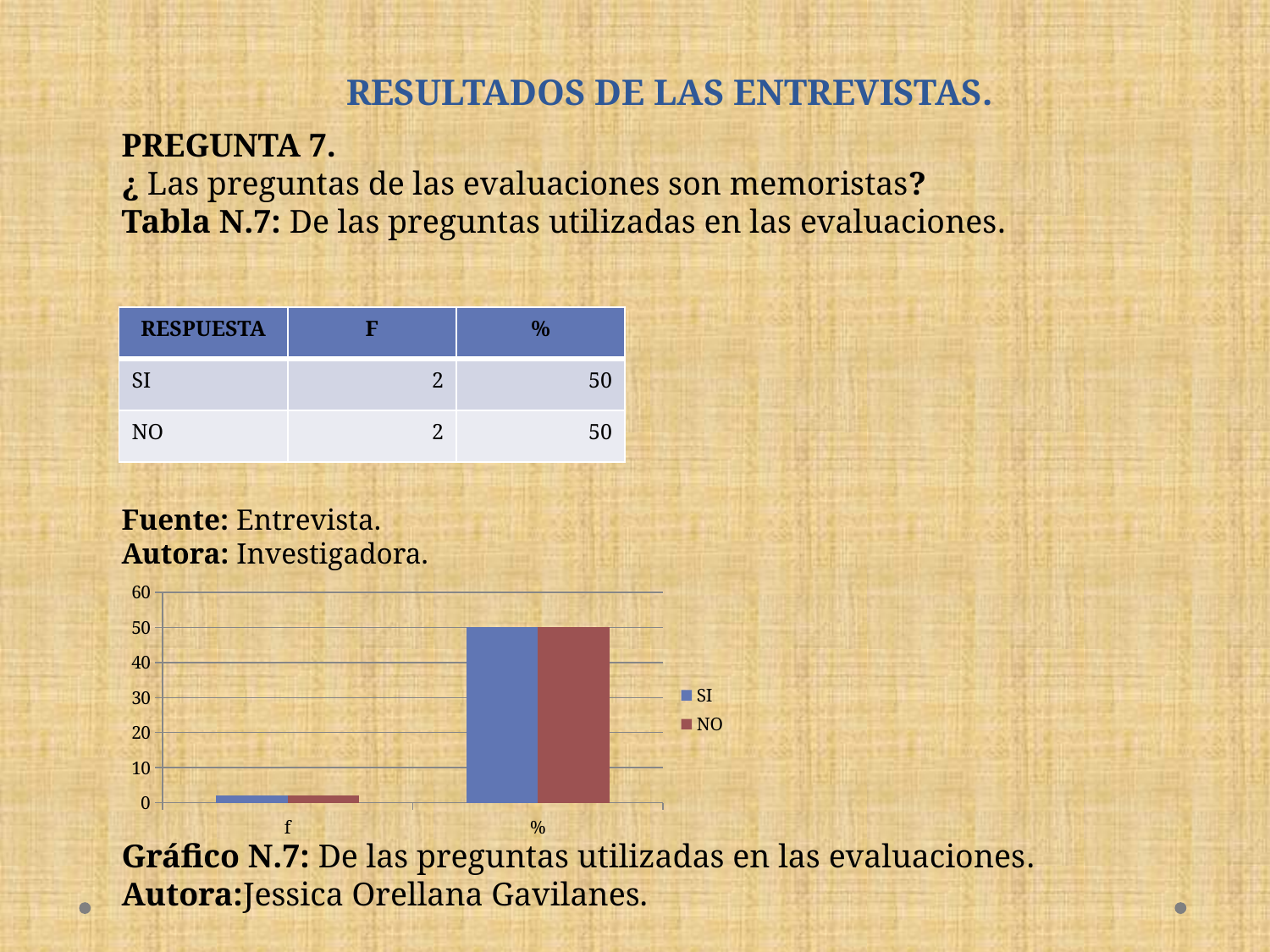
What are the category labels on the x axis of the chart? f and % What is the value of the SI bar for the % category? 50 What is the value of the SI bar for the f category? 2 How many series does the chart legend list? 2 Is the value of the SI bar for the % category greater or less than 40? greater For the SI series, which category has the larger value, f or %? % Which series are listed in the chart legend? SI and NO What is the difference between the SI value for % and the SI value for f? 48 What is the value of the NO bar for the % category? 50 How many categories are shown on the x axis of the chart? 2 What kind of chart is shown on the slide? bar chart Is the value of the NO bar for the f category greater or less than 10? less